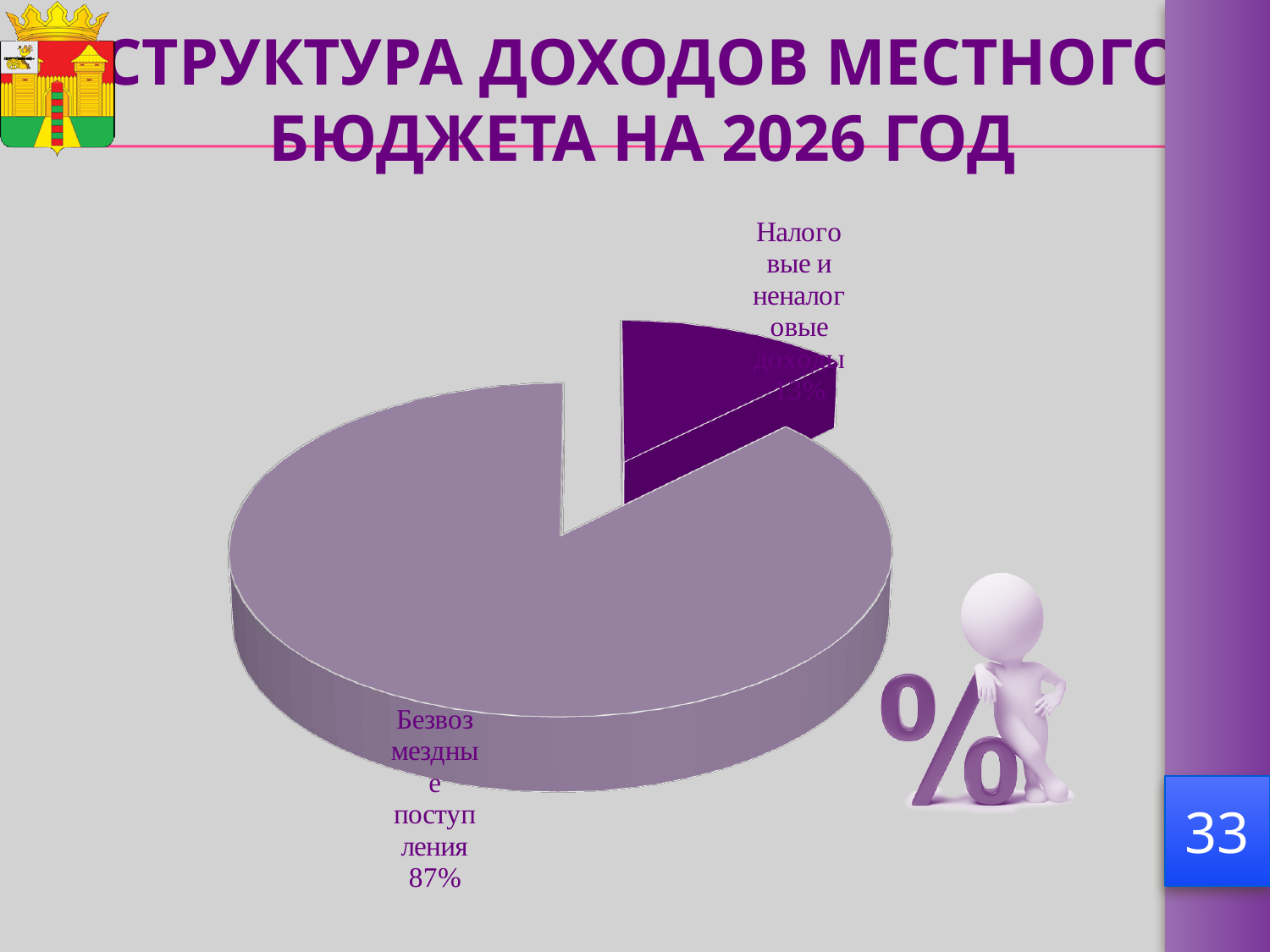
What is the title of the slide containing the pie chart? СТРУКТУРА ДОХОДОВ МЕСТНОГО БЮДЖЕТА НА 2026 ГОД Which slice of the pie is pulled out (exploded) from the rest? Налоговые и неналоговые доходы What share of the pie does "Налоговые и неналоговые доходы" take? 13% Which slice of the pie is the largest? Безвозмездные поступления What kind of chart is shown on the slide? pie chart How many slices does the pie chart have? 2 Which slice of the pie is the smallest? Налоговые и неналоговые доходы What share of the pie does "Безвозмездные поступления" take? 87% By how many percentage points does the share of "Безвозмездные поступления" exceed the share of "Налоговые и неналоговые доходы"? 74 Which is larger: the share for "Безвозмездные поступления" or the share for "Налоговые и неналоговые доходы"? Безвозмездные поступления